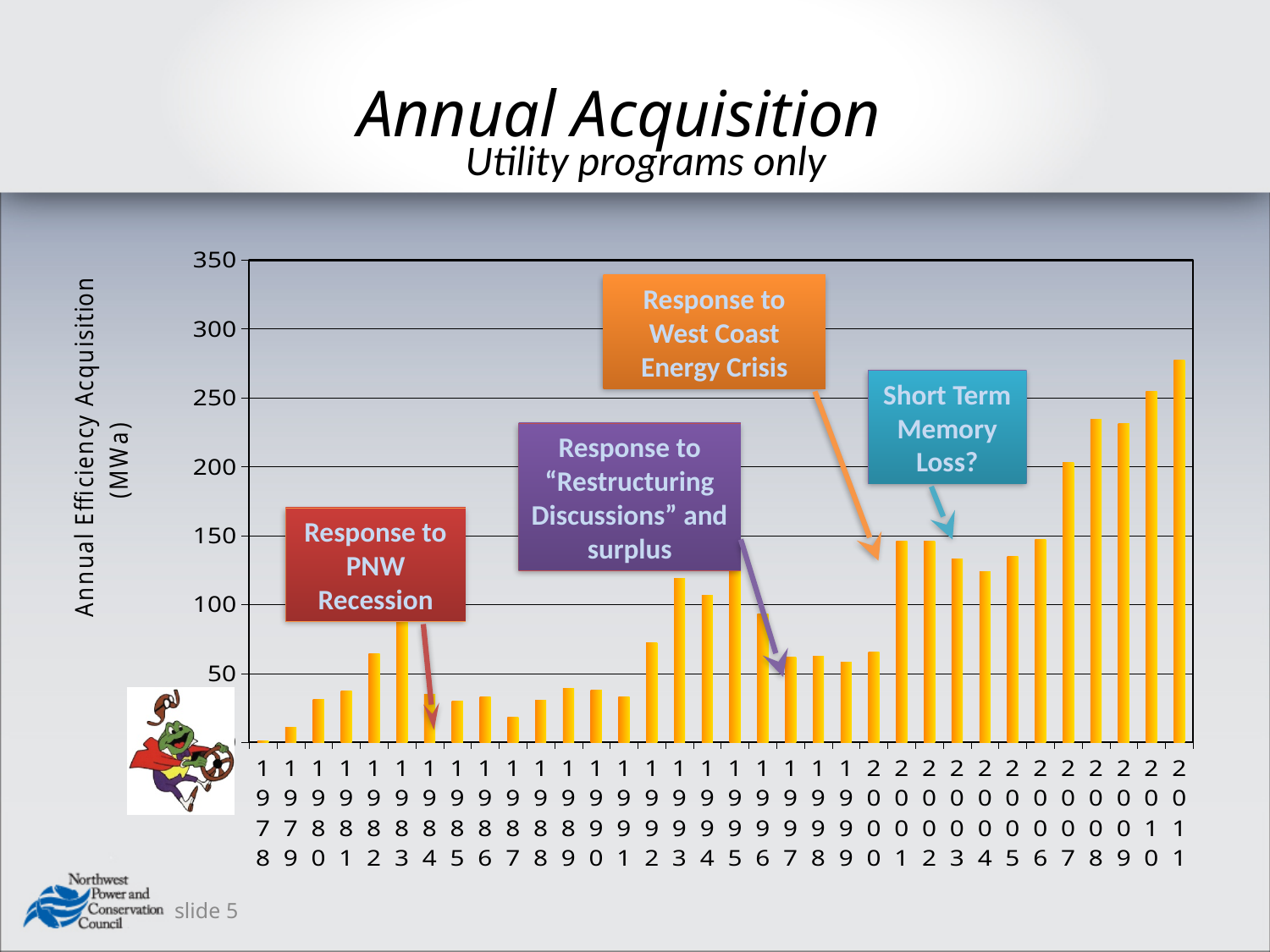
Which year has the highest annual efficiency acquisition? 2011 Is the value for 1987 greater or less than 50? less Which year has the larger value, 1983 or 1984? 1983 What is the label on the vertical axis of the chart? Annual Efficiency Acquisition (MWa) Do the values generally rise or fall from 2006 to 2011? rise Is the value for 2011 greater or less than 250? greater What kind of chart is shown on the slide? bar chart Is the value for 2001 greater or less than 100? greater Which year has the larger value, 2001 or 1999? 2001 Which year has the lowest annual efficiency acquisition? 1978 How many years (bars) are plotted on the chart? 34